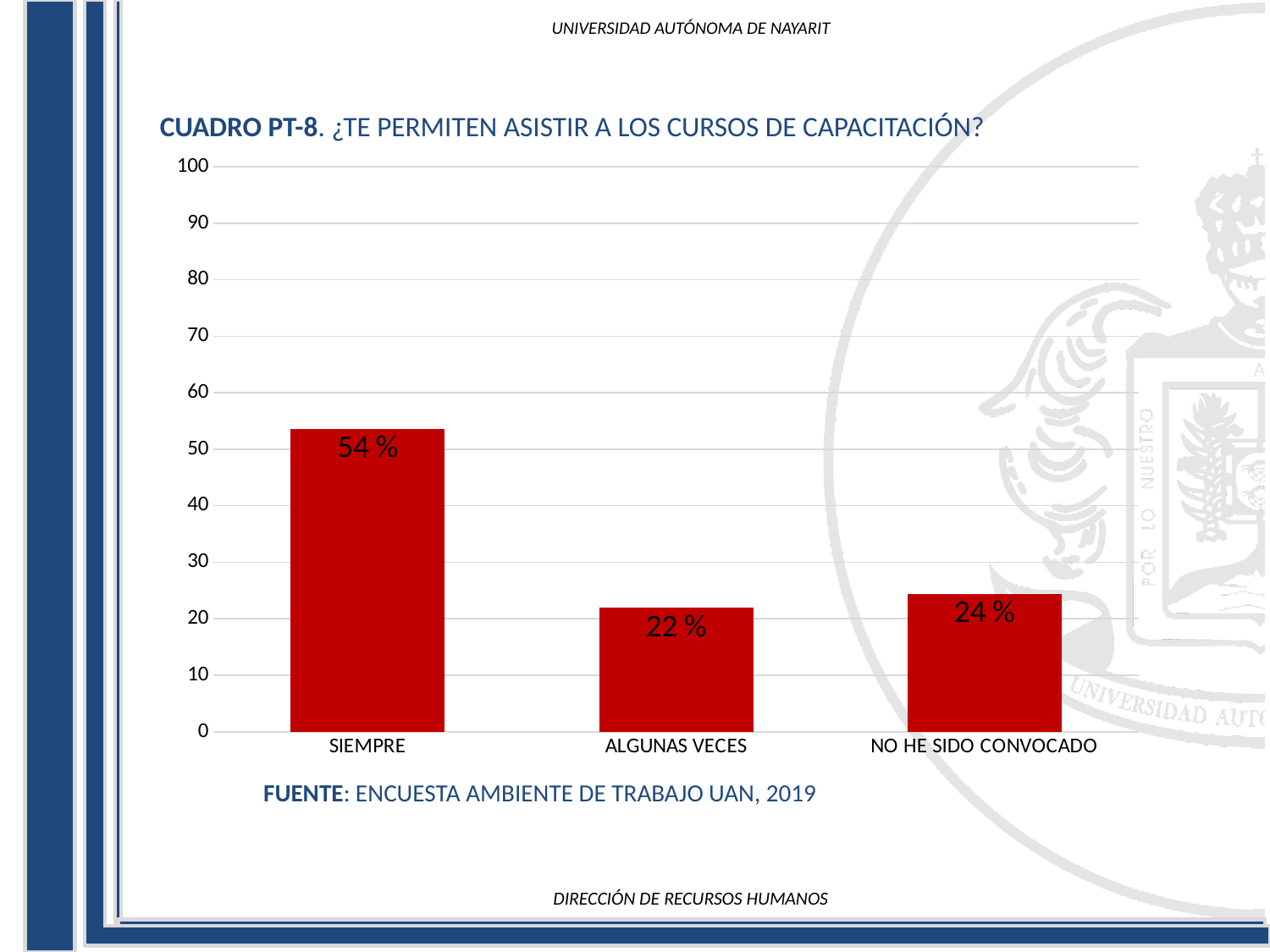
What is the source cited below the chart? ENCUESTA AMBIENTE DE TRABAJO UAN, 2019 Which is larger, the value for SIEMPRE or the value for NO HE SIDO CONVOCADO? SIEMPRE What is the value for ALGUNAS VECES? 22 % Which category has the lowest value? ALGUNAS VECES What is the value for NO HE SIDO CONVOCADO? 24 % What kind of chart is shown on the slide? bar chart How many categories are shown on the x axis? 3 Which category has the highest value? SIEMPRE What is the value for SIEMPRE? 54 % Is the value for SIEMPRE greater or less than 50? greater What is the difference between the values for NO HE SIDO CONVOCADO and ALGUNAS VECES? 2 % What is the difference between the values for SIEMPRE and ALGUNAS VECES? 32 %